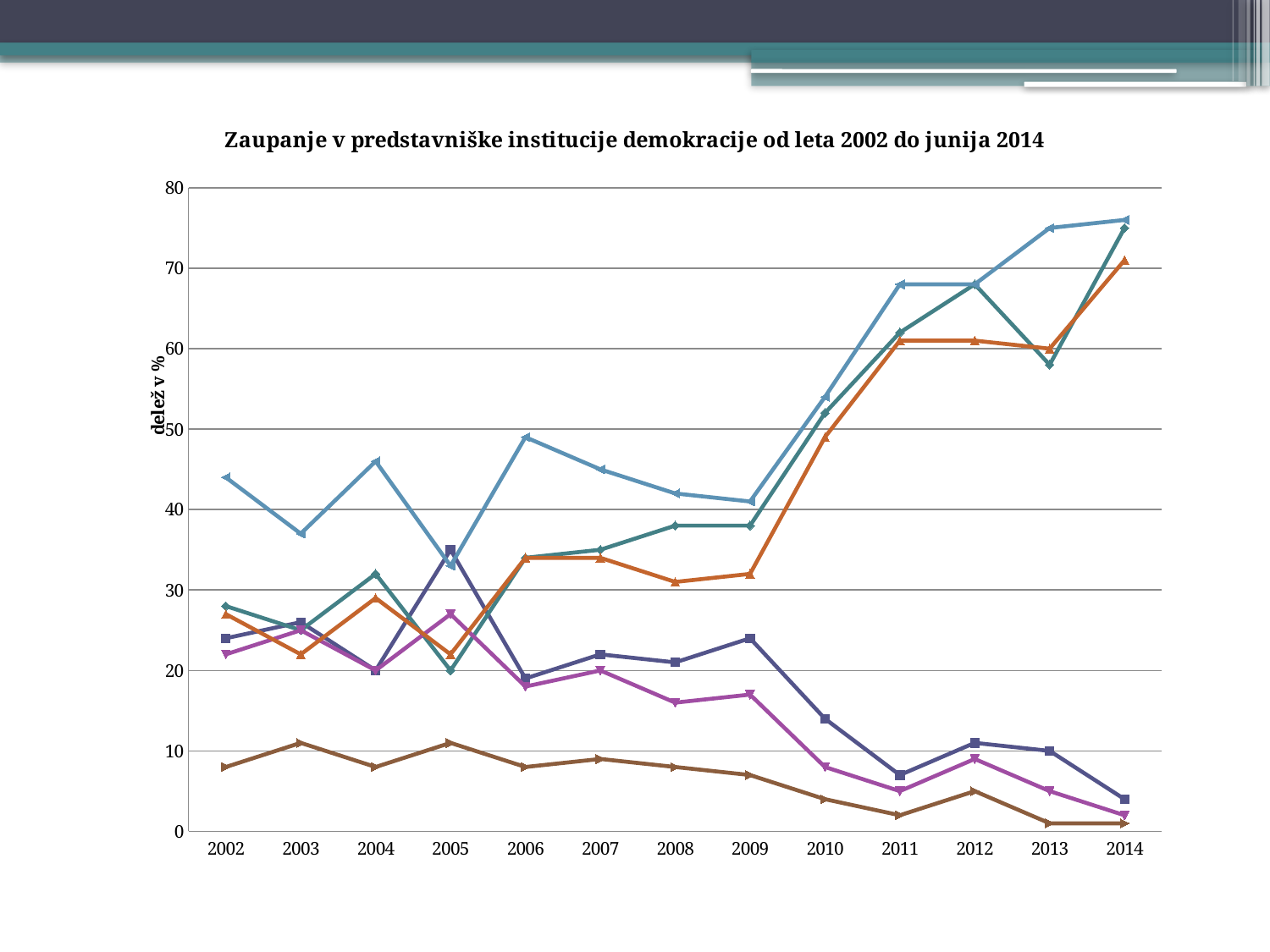
Does the light blue line rise or fall overall from 2009 to 2014? rise How many lines are plotted on the chart? 6 Is the value of the light blue line in 2014 greater or less than 70? greater What is the title of the chart? Zaupanje v predstavniške institucije demokracije od leta 2002 do junija 2014 How many years are shown along the x axis? 13 Is the value of the brown line in 2013 greater or less than 10? less Is the value of the orange line in 2011 greater or less than 50? greater Which line has the highest value in 2014, the light blue line or the brown line? light blue line What is the label of the vertical axis? delež v % Does the brown line rise or fall overall from 2009 to 2014? fall What kind of chart is shown on the slide? line chart